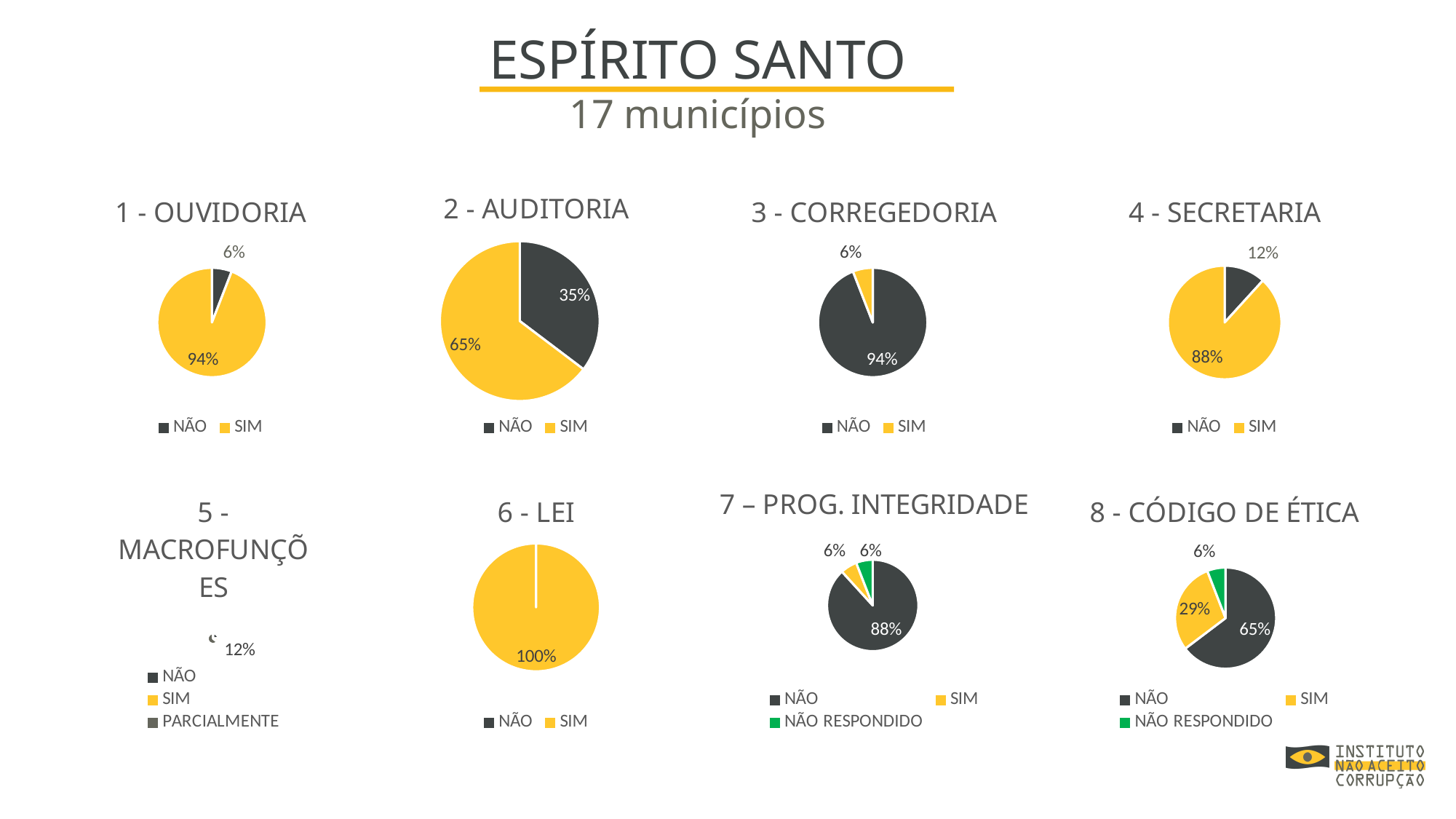
In the "2 - AUDITORIA" chart, what percentage is labelled for NÃO? 35% What type of chart is used for "2 - AUDITORIA"? Pie chart In the "6 - LEI" chart, what percentage is shown for SIM? 100% What colour represents SIM in the "1 - OUVIDORIA" chart? Yellow How many entries does the legend of the "7 – PROG. INTEGRIDADE" chart list? 3 How many entries does the legend of the "5 - MACROFUNÇÕES" chart list? 3 In the "4 - SECRETARIA" chart, what is the difference between the SIM and NÃO percentages? 76% In the "8 - CÓDIGO DE ÉTICA" chart, what percentage is labelled for SIM? 29% In the "1 - OUVIDORIA" chart, what share of the pie is SIM? 94% In the "7 – PROG. INTEGRIDADE" chart, which category has the largest slice? NÃO In the "3 - CORREGEDORIA" chart, which slice is larger, NÃO or SIM? NÃO In the "8 - CÓDIGO DE ÉTICA" chart, which category has the smallest slice? NÃO RESPONDIDO